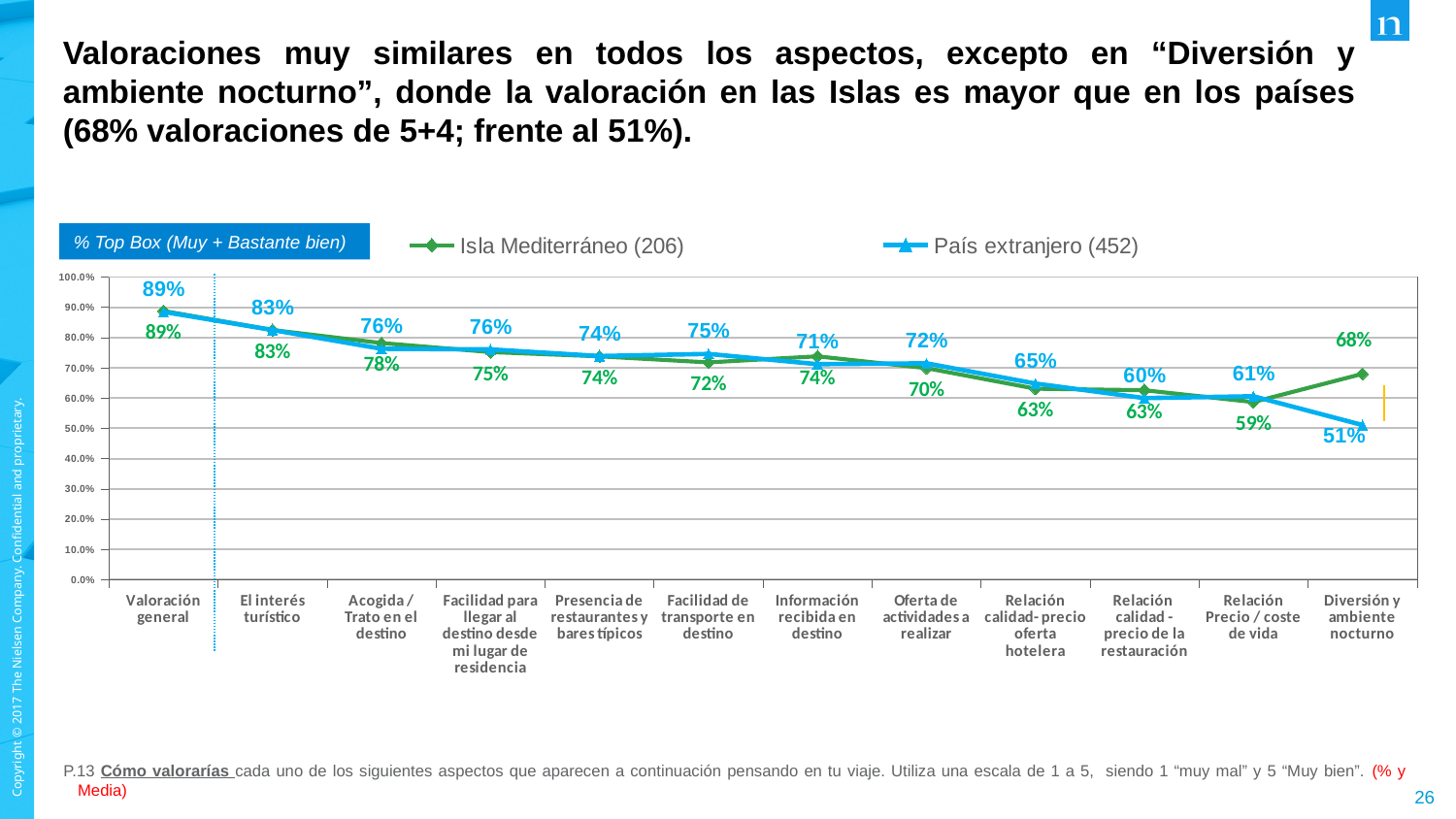
Which category has the highest value for Isla Mediterráneo (206)? Valoración general What is the value for País extranjero (452) for "Diversión y ambiente nocturno"? 51% How many categories are plotted along the x axis of the chart? 12 For "Facilidad de transporte en destino", which series has the larger value, Isla Mediterráneo (206) or País extranjero (452)? País extranjero (452) What is the difference between Isla Mediterráneo (206) and País extranjero (452) for "Diversión y ambiente nocturno"? 17% What is the value for Isla Mediterráneo (206) for "Diversión y ambiente nocturno"? 68% What type of chart is shown on the slide? line chart How many series does the chart legend list? 2 Do the values for País extranjero (452) generally rise or fall from left to right along the x axis? fall What is the value for Isla Mediterráneo (206) for "Oferta de actividades a realizar"? 70% Which category has the lowest value for País extranjero (452)? Diversión y ambiente nocturno What is the value for País extranjero (452) for "Relación calidad-precio oferta hotelera"? 65%